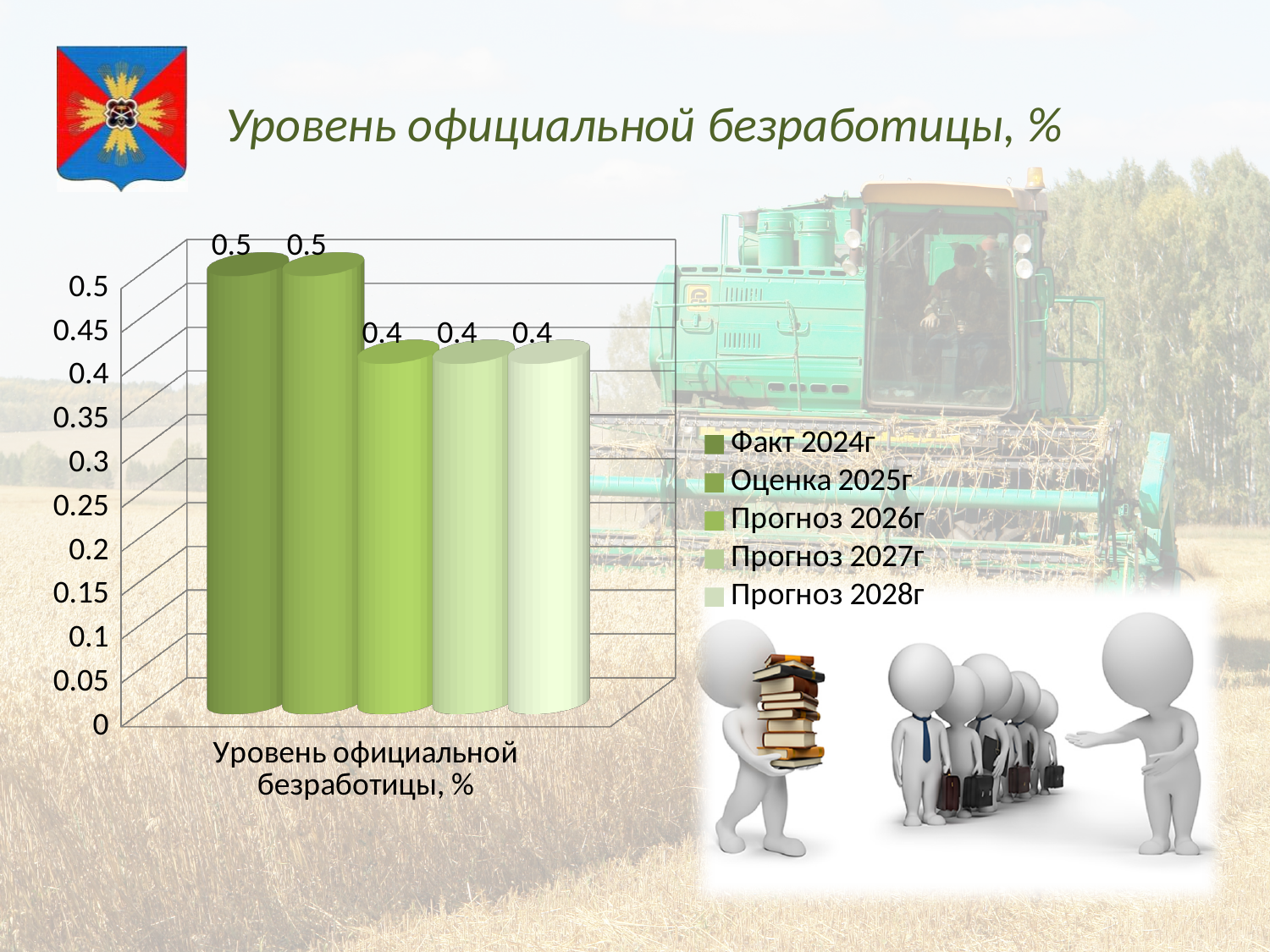
What is the value for Прогноз 2026г? 0.4 What is the difference between the values for Факт 2024г and Прогноз 2027г? 0.1 How many series does the legend list? 5 What is the value for Прогноз 2028г? 0.4 Is the value for Факт 2024г greater or less than 0.3? greater Do the values rise or fall from Факт 2024г to Прогноз 2028г? fall Is the value for Прогноз 2027г greater or less than 0.45? less Which is larger, the value for Оценка 2025г or the value for Прогноз 2026г? Оценка 2025г What is the value for Оценка 2025г? 0.5 What kind of chart is shown on the slide? bar chart What is the title of the chart? Уровень официальной безработицы, % What is the value for Факт 2024г? 0.5